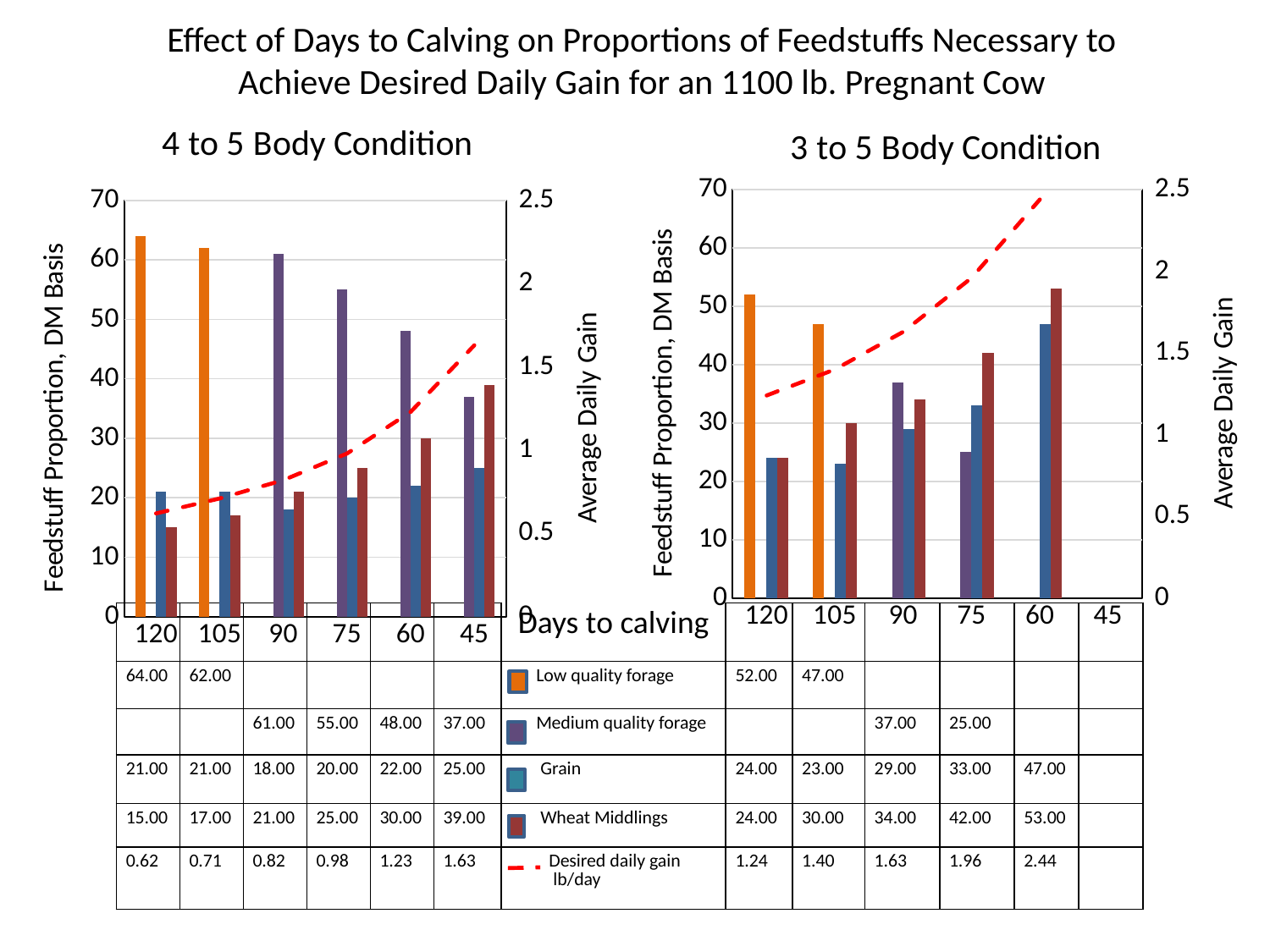
In the 3 to 5 Body Condition chart, at which days-to-calving value is the Grain proportion highest? 60 What kind of chart is used for the feedstuff proportions in the 3 to 5 Body Condition chart? Bar chart In the 3 to 5 Body Condition chart, is the Low quality forage proportion at 120 days greater or less than 50? greater In the 4 to 5 Body Condition chart, what is the difference between the Medium quality forage proportion at 90 days and at 45 days? 24.00 In the 3 to 5 Body Condition chart, what is the Wheat Middlings proportion at 60 days to calving? 53.00 How many series does the legend between the two charts list? 5 In the 3 to 5 Body Condition chart, does the Desired daily gain rise or fall from 120 days to 60 days to calving? Rise In the 3 to 5 Body Condition chart, which is larger at 75 days to calving: Grain or Wheat Middlings? Wheat Middlings In the 4 to 5 Body Condition chart, at which days-to-calving value is the Wheat Middlings proportion lowest? 120 In the 4 to 5 Body Condition chart, what is the Low quality forage proportion at 120 days to calving? 64.00 How many days-to-calving categories are shown on the x axis of the 4 to 5 Body Condition chart? 6 In the 4 to 5 Body Condition chart, what is the Desired daily gain at 45 days to calving? 1.63